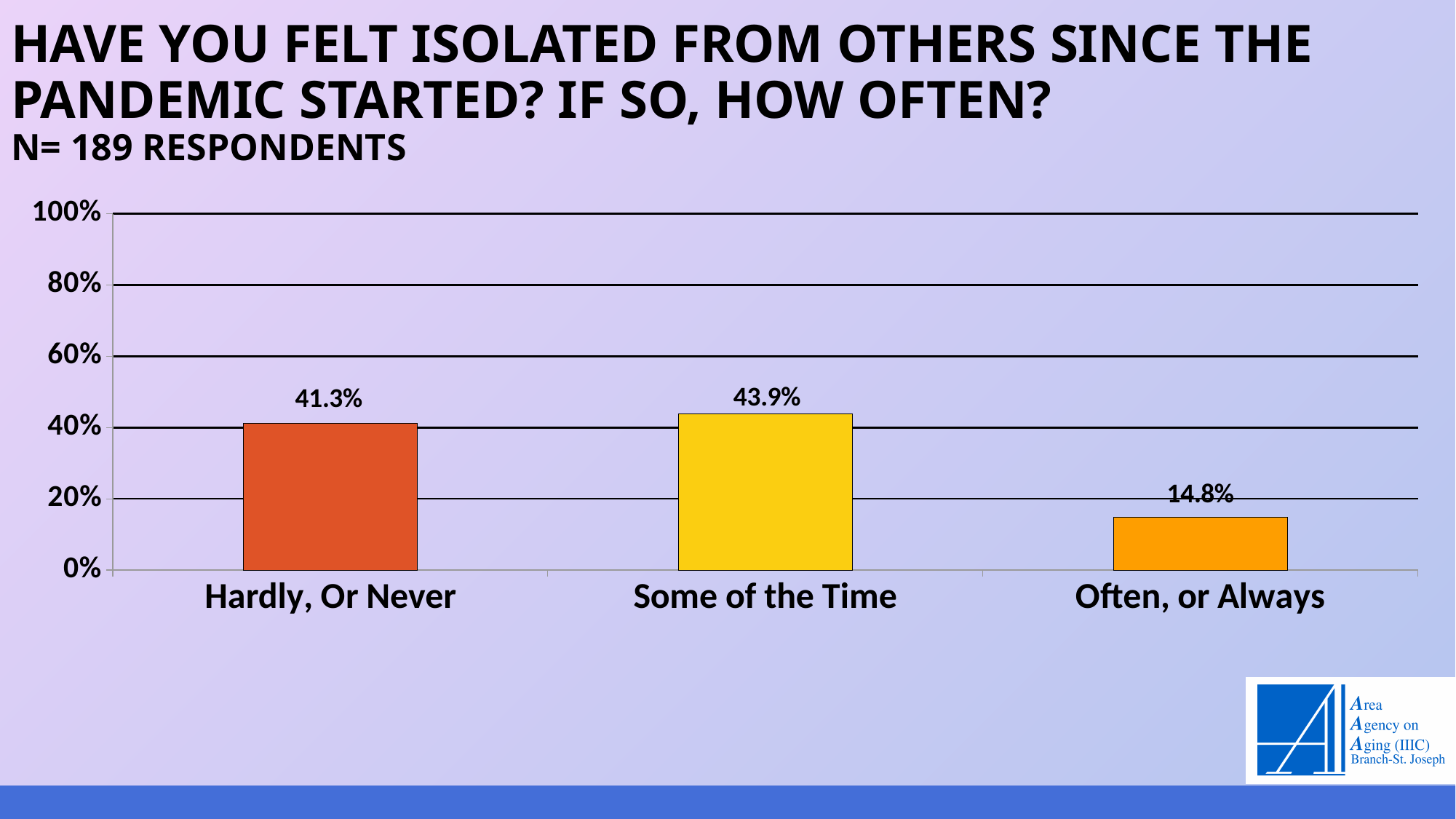
What kind of chart is shown on the slide? Bar chart What is the difference in percentage points between "Hardly, Or Never" and "Often, or Always"? 26.5 percentage points Which response category has the highest percentage? Some of the Time Is the value for "Often, or Always" greater or less than 20%? less Which is larger: the value for "Hardly, Or Never" or the value for "Often, or Always"? Hardly, Or Never Which response category has the lowest percentage? Often, or Always What percentage of respondents answered "Often, or Always"? 14.8% What percentage of respondents answered "Hardly, Or Never"? 41.3% How many response categories are shown on the chart? 3 What percentage of respondents answered "Some of the Time"? 43.9% How many respondents does the slide say took part in the survey? 189 What is the difference in percentage points between "Some of the Time" and "Hardly, Or Never"? 2.6 percentage points